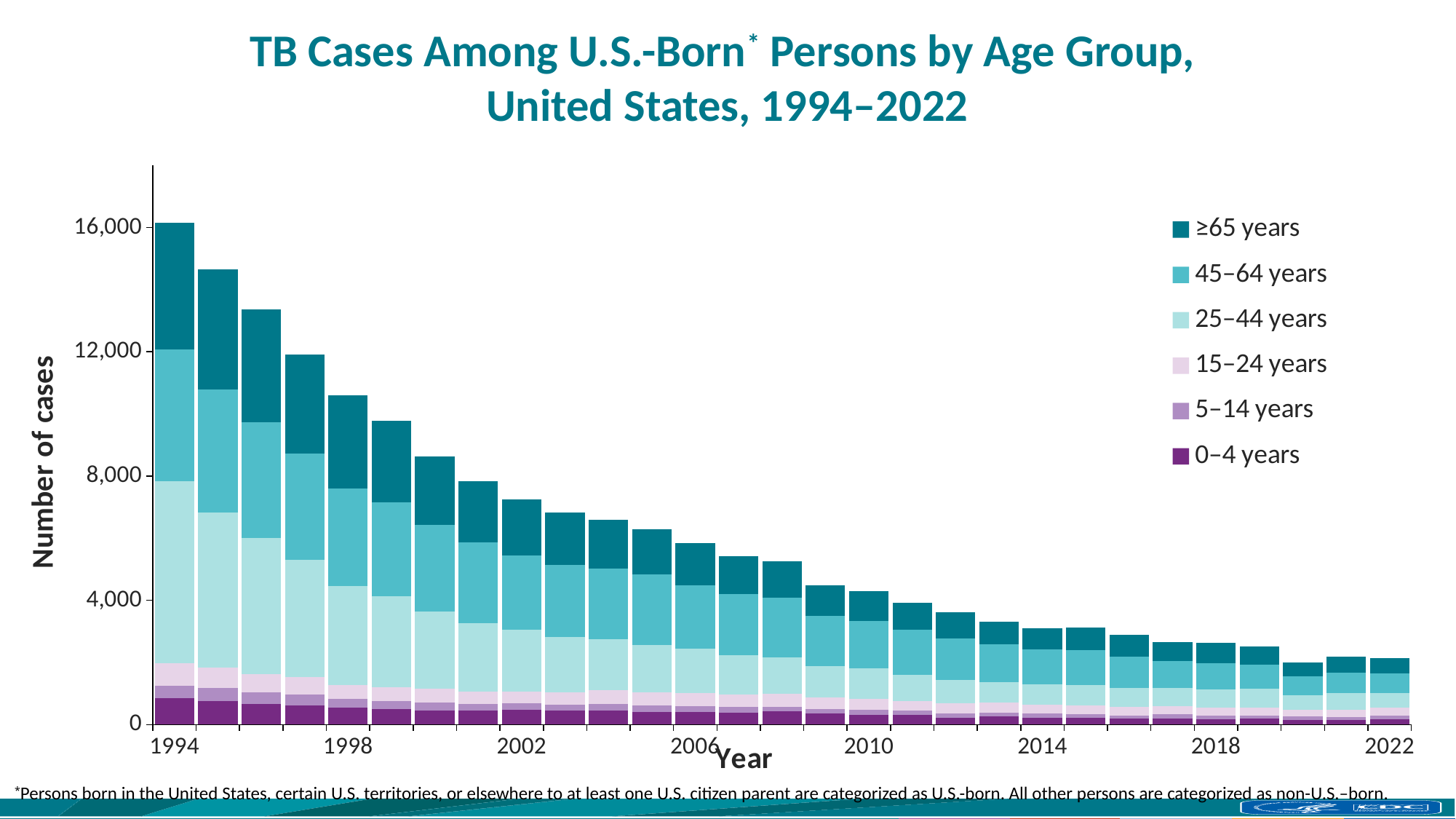
What is the label of the y-axis? Number of cases Which year has the larger total number of cases, 1998 or 2010? 1998 Which age group is listed first (at the top) in the legend? ≥65 years Is the total number of cases in 2022 greater or less than 4,000? less Is the total number of cases in 2006 greater or less than 4,000? greater Do the total TB cases among U.S.-born persons rise or fall from 1994 to 2022? Fall Which year has the highest total number of TB cases? 1994 Is the total number of cases in 1998 greater or less than 8,000? greater What kind of chart is shown on the slide? Stacked bar chart How many series does the legend list? 6 How many years (bars) are plotted on the chart? 29